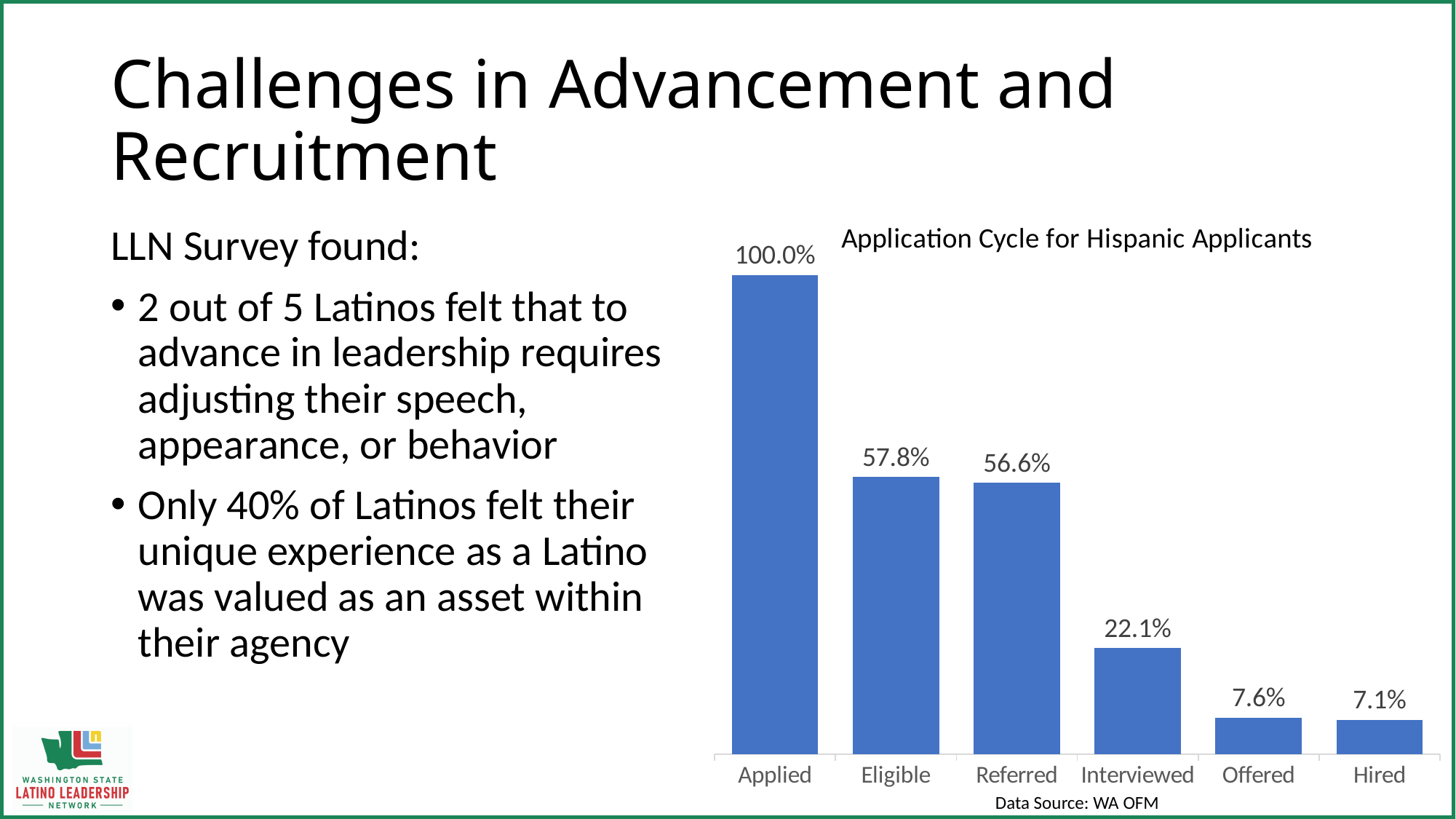
What is the value for Hired in the chart? 7.1% What is the difference between the values for Eligible and Referred? 1.2% Do the values rise or fall from Applied to Hired along the x axis? Fall Which category has the highest value in the chart? Applied Which is larger, the value for Offered or the value for Hired? Offered Which category has the lowest value in the chart? Hired How many categories are shown on the x axis of the chart? 6 What is the title of the chart on the slide? Application Cycle for Hispanic Applicants What is the value for Eligible in the Application Cycle for Hispanic Applicants chart? 57.8% What is the difference between the values for Applied and Interviewed? 77.9% What is the value for Interviewed in the chart? 22.1% What kind of chart is shown on the slide? Bar chart